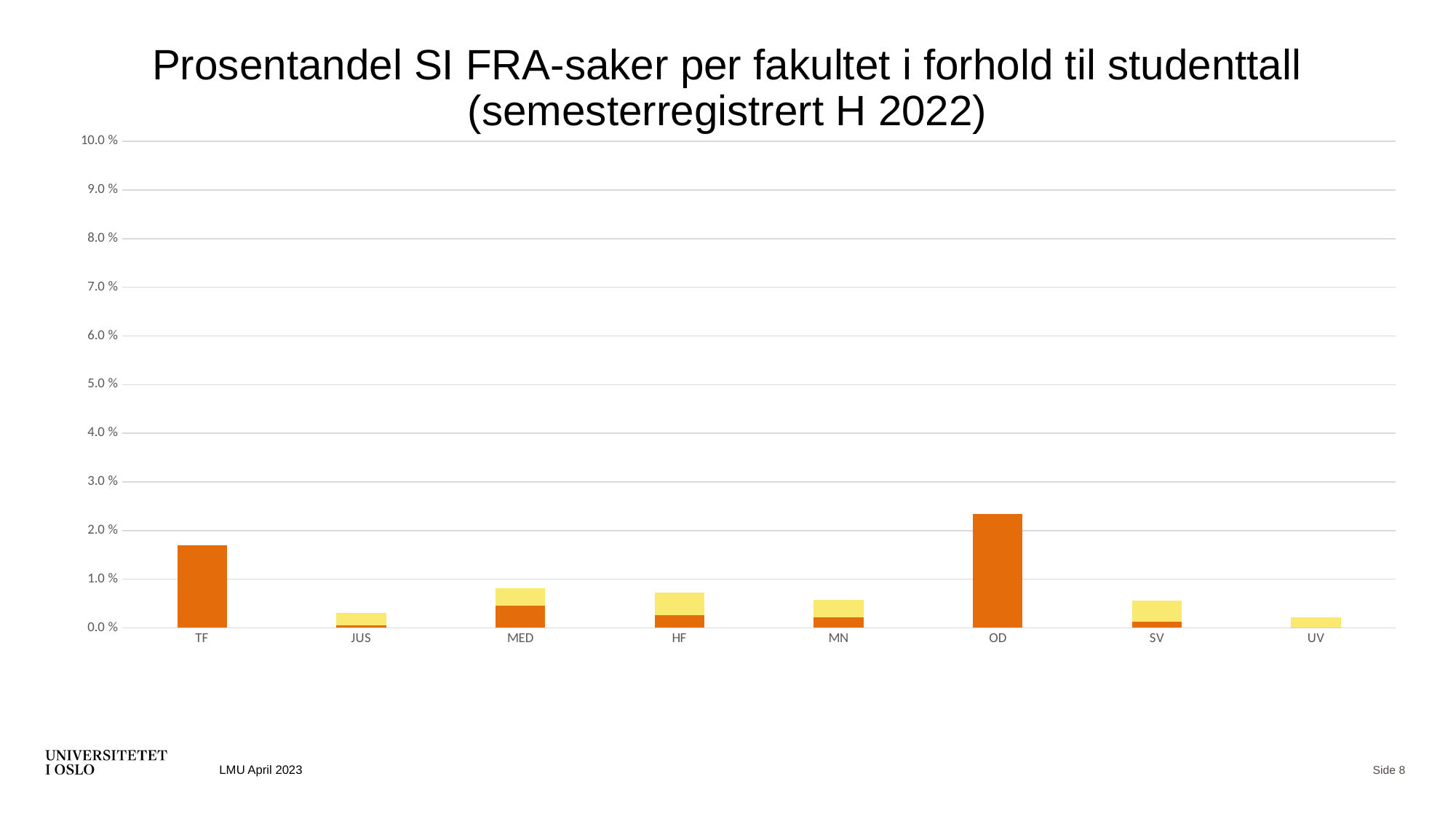
Which faculty has the highest total bar? OD Is the value for TF greater or less than 1.0 %? greater Is the total value for MED greater or less than 1.0 %? less How many faculties (categories) are shown on the x axis? 8 Is the total value for OD greater or less than 3.0 %? less What kind of chart is shown on the slide? bar chart What is the highest value shown on the y axis? 10.0 % Which has the larger total bar, TF or MED? TF Which has the larger total bar, OD or TF? OD